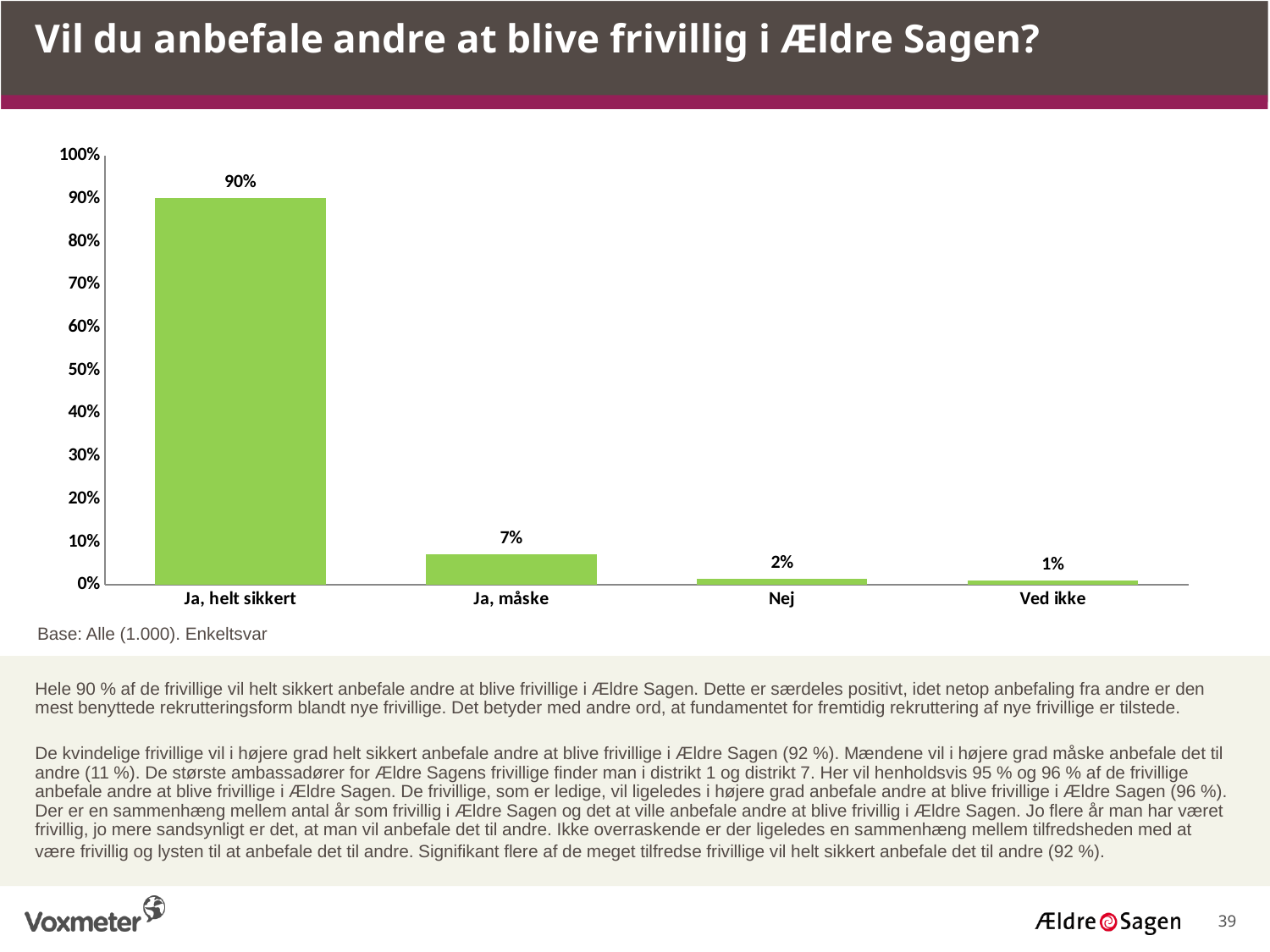
What is the value for "Ja, helt sikkert"? 90% What is the title of the slide? Vil du anbefale andre at blive frivillig i Ældre Sagen? Which is larger, the value for "Nej" or the value for "Ved ikke"? Nej What is the value for "Nej"? 2% Which category has the highest value? Ja, helt sikkert What is the difference between the values for "Ja, helt sikkert" and "Ja, måske"? 83% Is the value for "Ja, helt sikkert" greater or less than 80%? greater What kind of chart is shown on the slide? Bar chart Which category has the lowest value? Ved ikke What is the value for "Ved ikke"? 1% What is the value for "Ja, måske"? 7% How many categories are shown on the x axis? 4